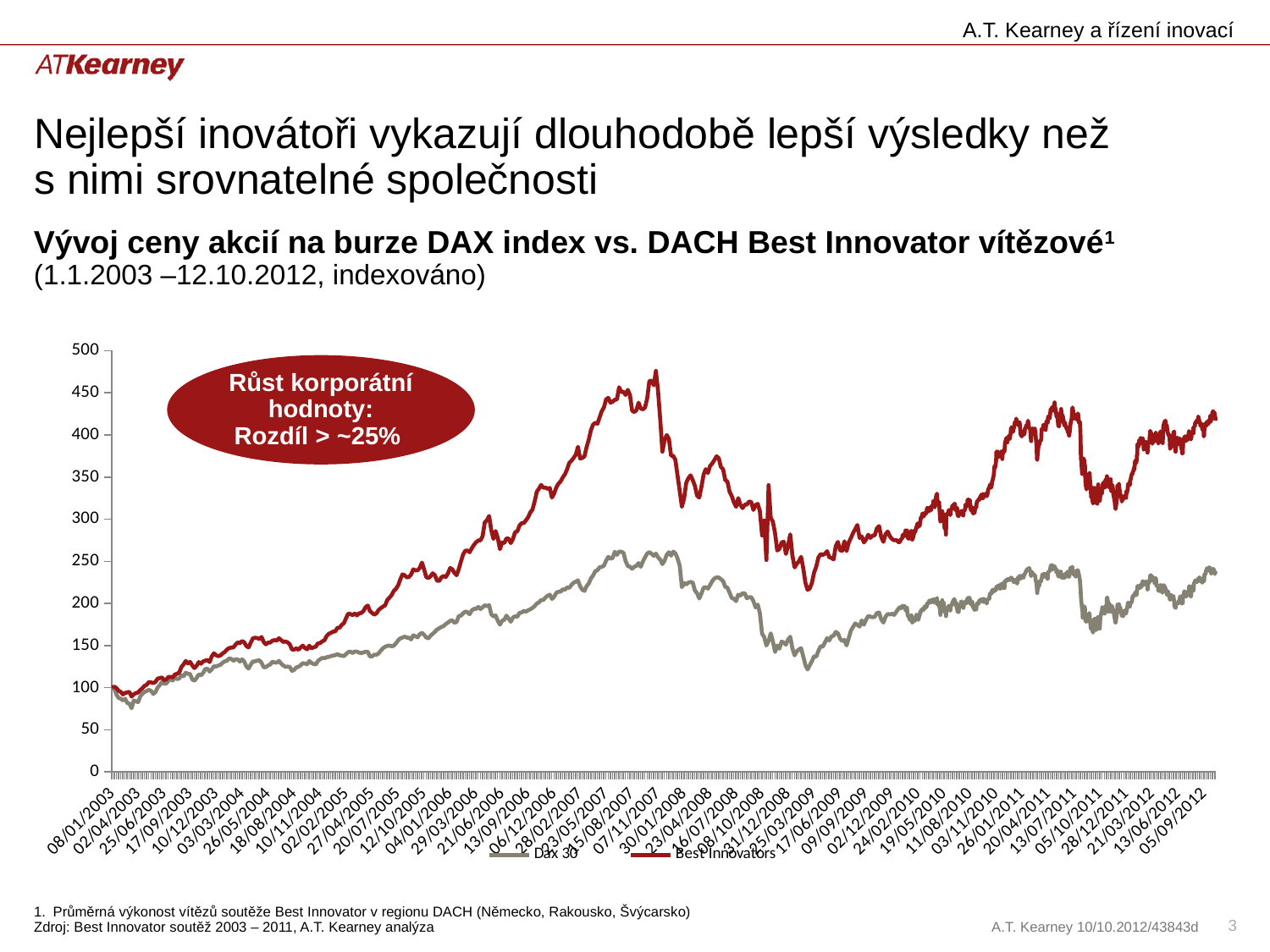
Which series is higher at the end of the period, Dax 30 or Best Innovators? Best Innovators Is the peak value of the Best Innovators line in late 2007 greater or less than 450? greater What kind of chart is shown on the slide? line chart Is the lowest value of the Dax 30 line in early 2009 greater or less than 150? less Is the peak value of the Dax 30 line in 2007 greater or less than 300? less Which two series are plotted in the chart? Dax 30 and Best Innovators At what indexed value do both series start at the beginning of 2003? 100 What colour is the Best Innovators line? red Do the values of the Best Innovators line rise or fall between the start of 2003 and the end of 2007? rise How many series does the legend list? 2